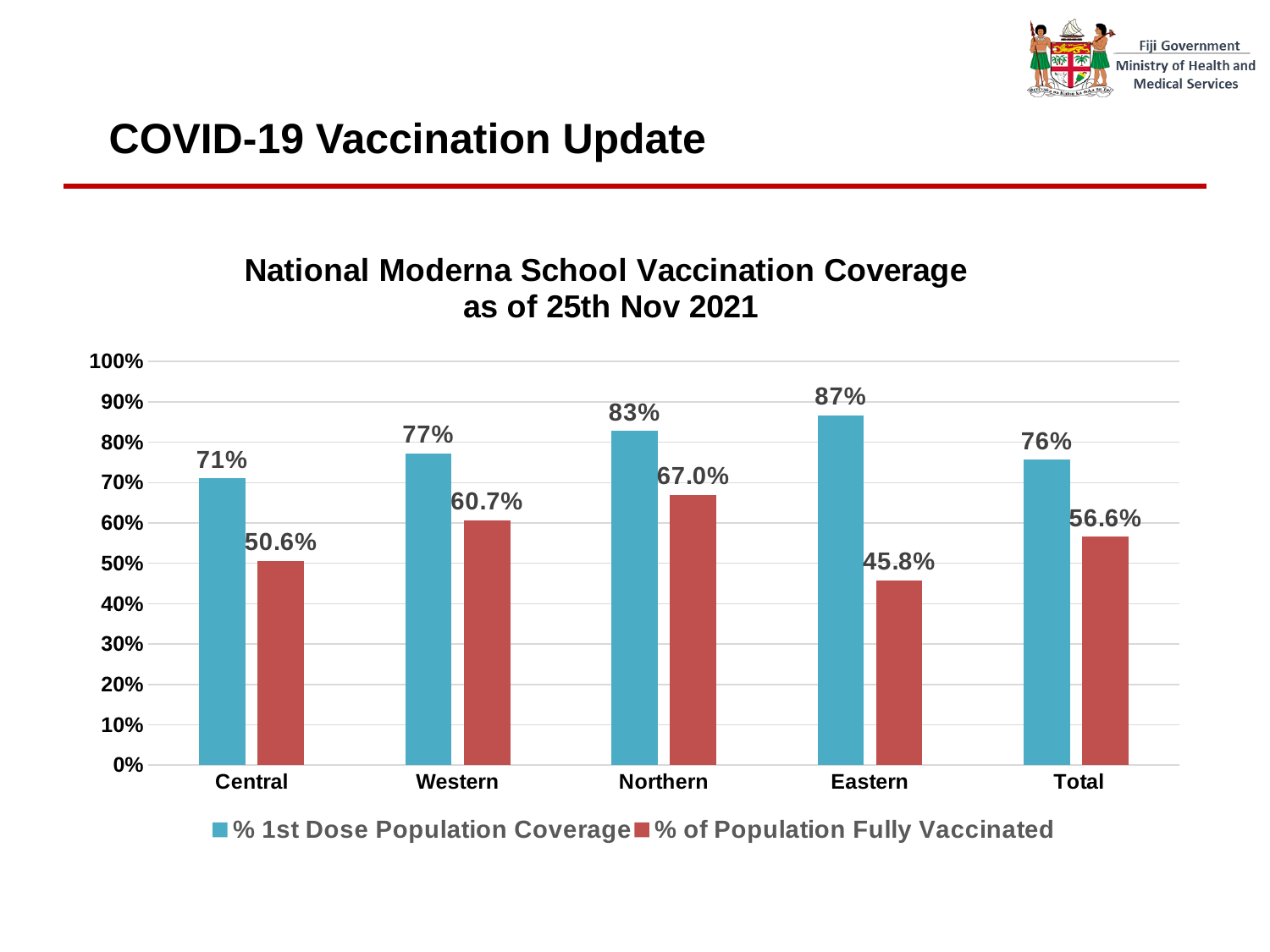
Is the % 1st Dose Population Coverage for Central greater or less than 60%? greater How many categories are shown on the x axis? 5 What kind of chart is shown on the slide? Bar chart What is the % 1st Dose Population Coverage for Northern? 83% Which is larger: the % of Population Fully Vaccinated for Western or for Total? Western What is the % of Population Fully Vaccinated for Total? 56.6% What is the title of the chart? National Moderna School Vaccination Coverage as of 25th Nov 2021 What is the difference between the % of Population Fully Vaccinated for Northern and for Central? 16.4% What is the % of Population Fully Vaccinated for Eastern? 45.8% Which category has the lowest % of Population Fully Vaccinated? Eastern Which category has the highest % 1st Dose Population Coverage? Eastern How many series does the legend list? 2